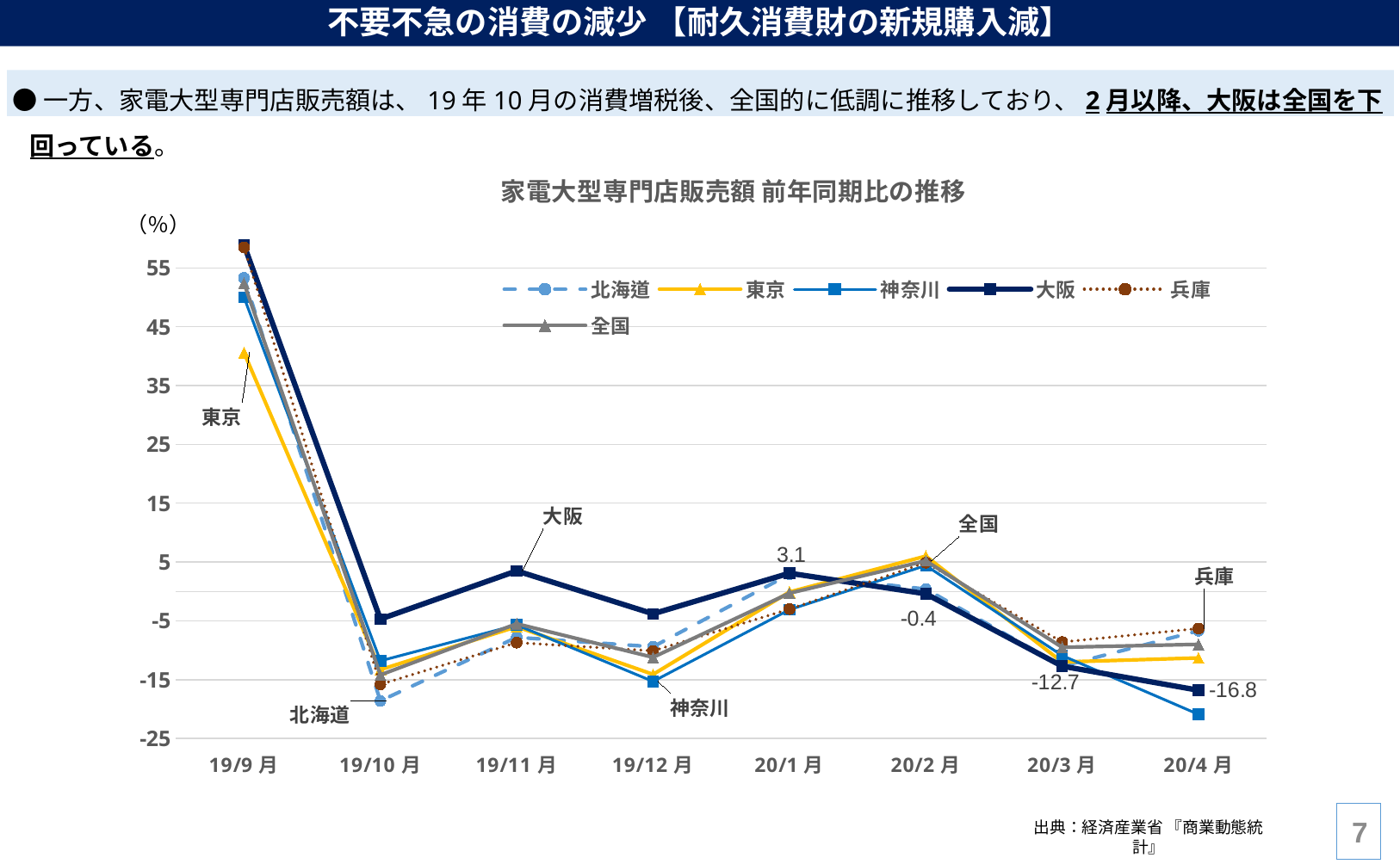
How many series does the legend list? 6 What kind of chart is shown on the slide? line chart Which is larger in 20/4月, the value for 大阪 or the value for 全国? 全国 What is the value for 大阪 in 20/2月? -0.4 Which series has the lowest value in 20/4月? 神奈川 What is the value for 大阪 in 20/1月? 3.1 Which series has the lowest value in 19/9月? 東京 How many months are shown along the x axis? 8 Is the value for 大阪 in 19/11月 greater or less than 0? greater What is the value for 大阪 in 20/4月? -16.8 What is the value for 大阪 in 20/3月? -12.7 By how much did the value for 大阪 fall from 20/3月 to 20/4月? 4.1